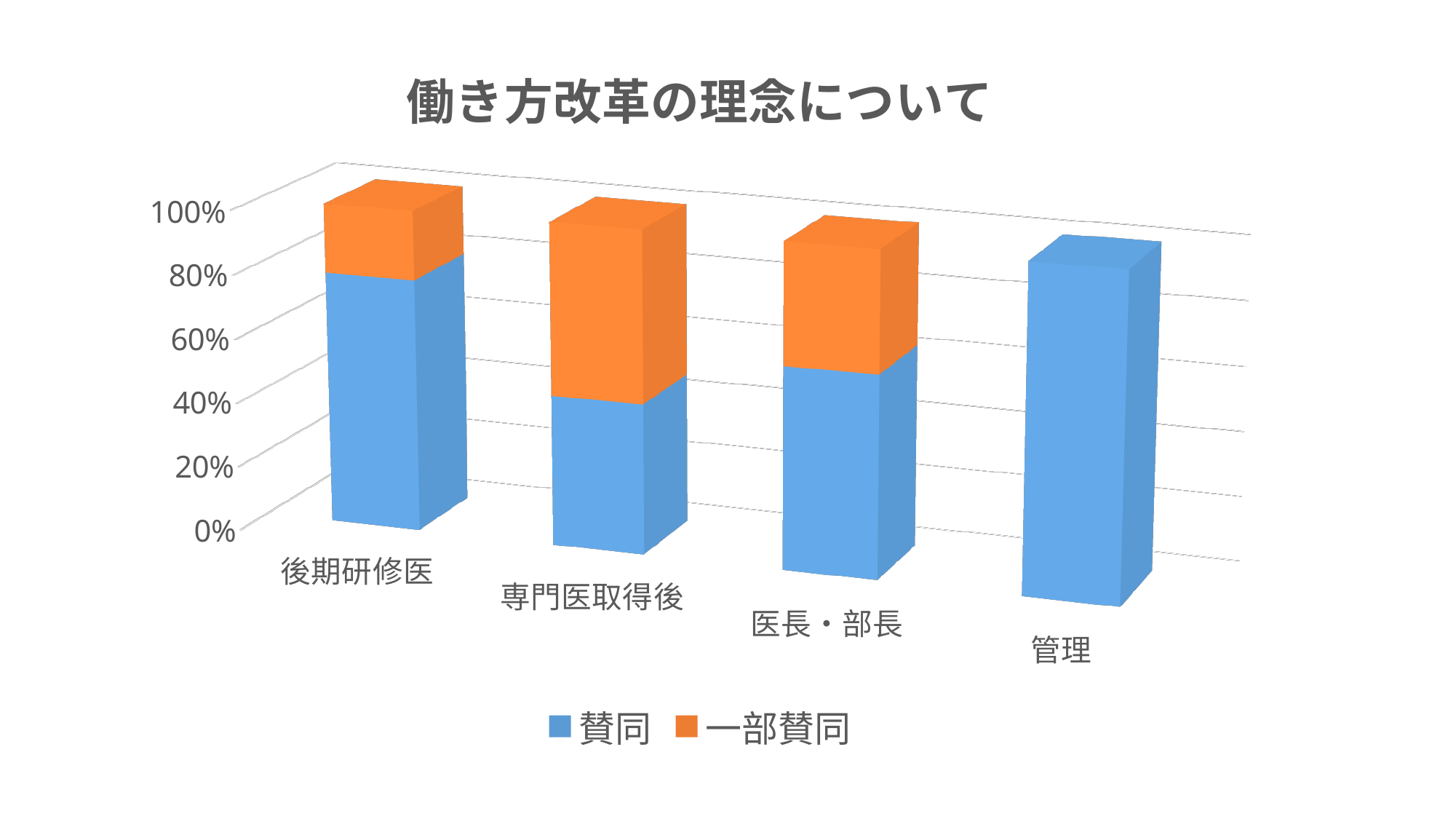
Is the 賛同 share for 専門医取得後 greater or less than 60%? less Is the 賛同 share for 後期研修医 greater or less than 60%? greater Which category has the largest share of 一部賛同? 専門医取得後 Which has a larger 一部賛同 share, 医長・部長 or 管理? 医長・部長 Which series is shown in orange? 一部賛同 How many series does the legend list? 2 Which category has the highest share of 賛同? 管理 Which has a larger 賛同 share, 後期研修医 or 専門医取得後? 後期研修医 What is the title of the chart? 働き方改革の理念について Which category has the lowest share of 賛同? 専門医取得後 What kind of chart is shown on the slide? Stacked bar chart How many categories are shown on the x axis? 4